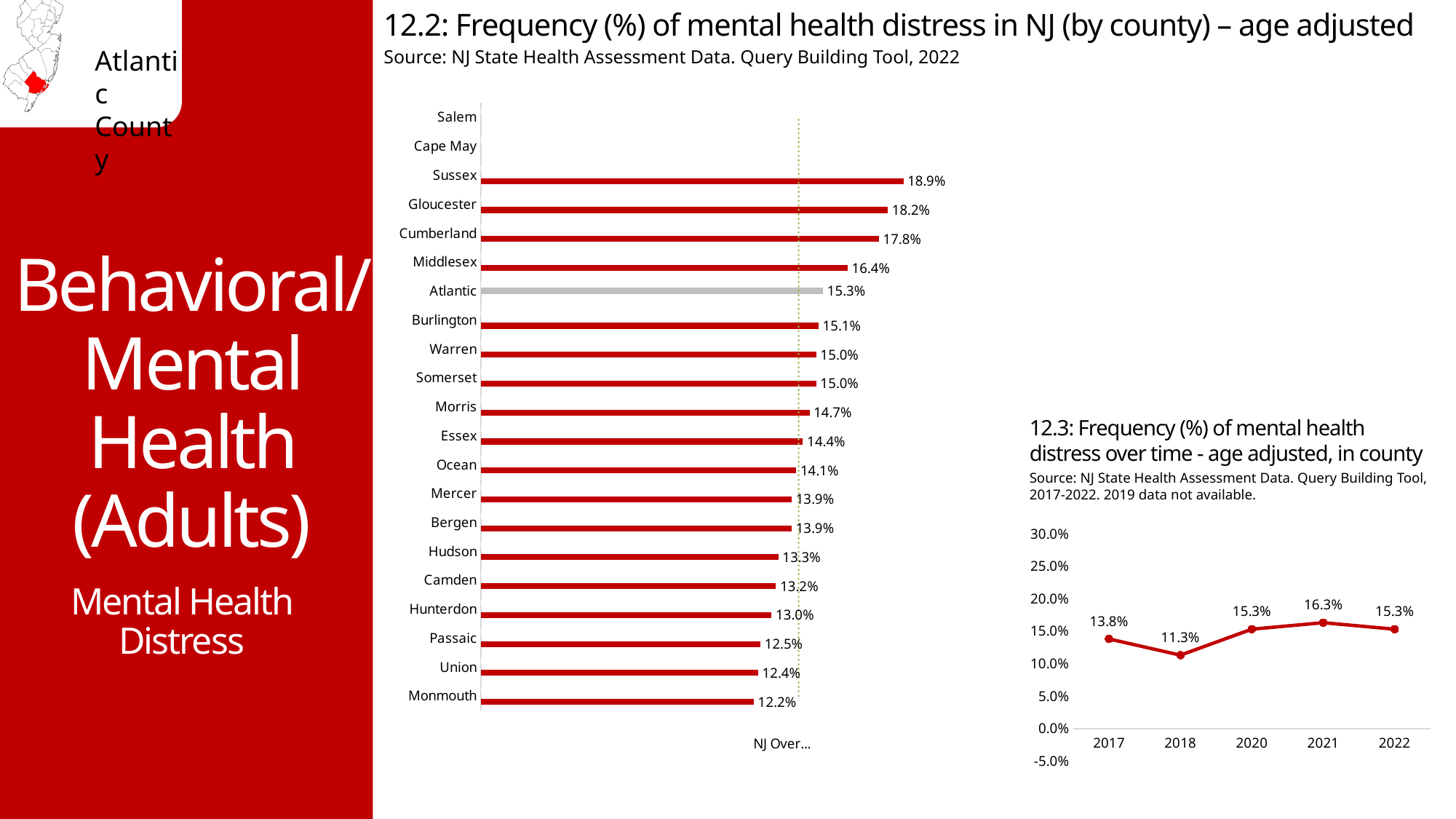
In chart 12.3, which year has the highest value? 2021 What kind of chart is chart 12.2? Bar chart In chart 12.3, is the value for 2020 greater or less than 10.0%? greater In chart 12.3, what is the value for 2018? 11.3% In chart 12.2, which county has the lowest labelled value? Monmouth In chart 12.2, which county has the highest value? Sussex In chart 12.2, what is the value for Cumberland? 17.8% In chart 12.2, which is larger, the value for Middlesex or the value for Essex? Middlesex In chart 12.3, how many data points are plotted? 5 In chart 12.2, what is the value for Atlantic? 15.3% In chart 12.2, what is the difference between the values for Sussex and Gloucester? 0.7% In chart 12.3, what is the difference between the values for 2021 and 2017? 2.5%